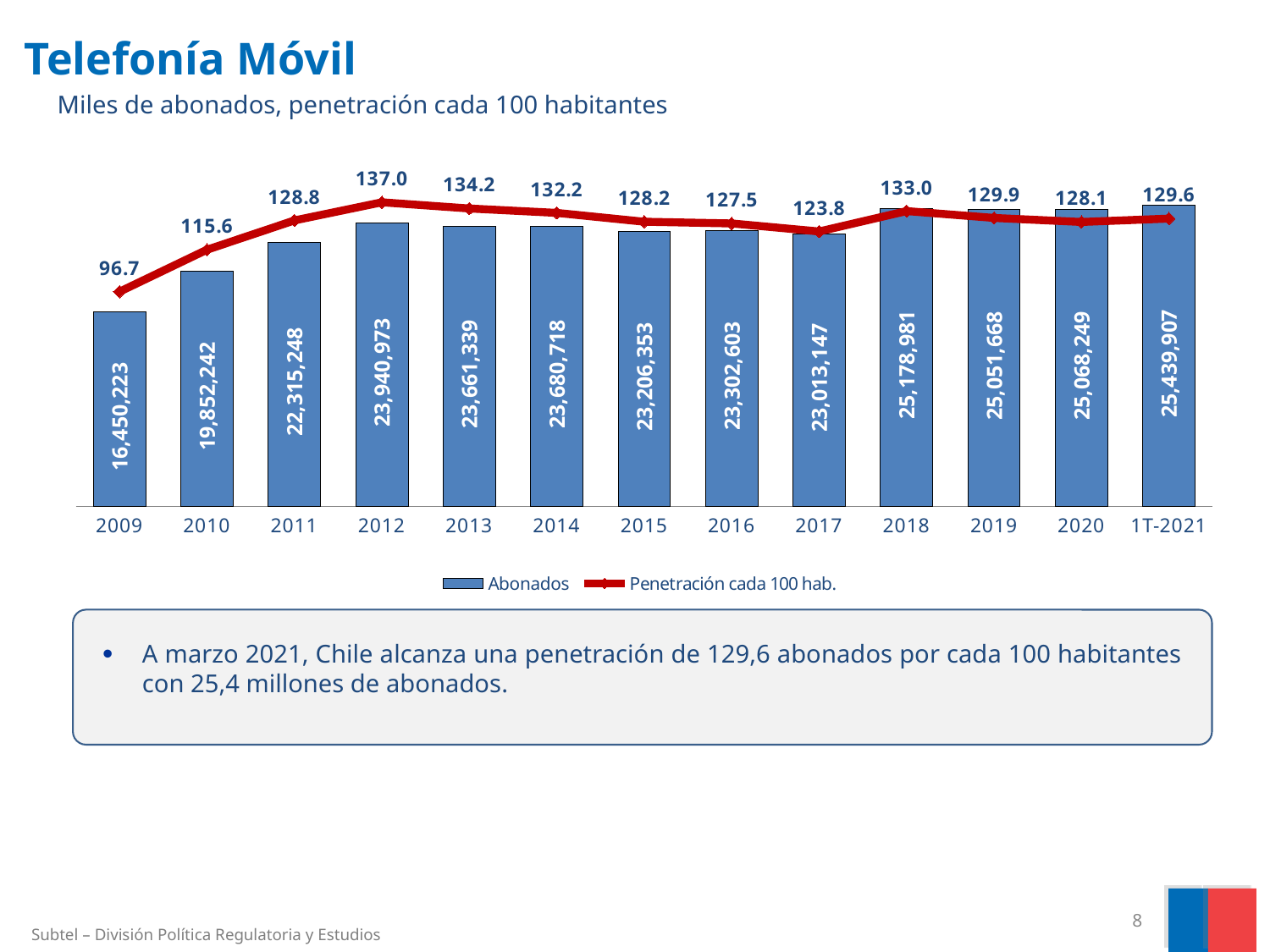
What is the number of Abonados shown for 1T-2021? 25,439,907 What is the difference between the Penetración cada 100 hab. values for 2012 and 2009? 40.3 In which year does the Penetración cada 100 hab. line reach its highest value? 2012 How many categories are shown on the x axis of the chart? 13 What is the Penetración cada 100 hab. value shown for 2017? 123.8 Does the Penetración cada 100 hab. line rise or fall between 2009 and 2012? Rise What is the number of Abonados shown for 2012? 23,940,973 How many series does the chart legend list? 2 Which category has the lowest number of Abonados? 2009 Which year has more Abonados, 2018 or 2019? 2018 What kind of chart is used to show the Abonados series? Bar chart By how much did the number of Abonados increase from 2020 to 1T-2021? 371,658